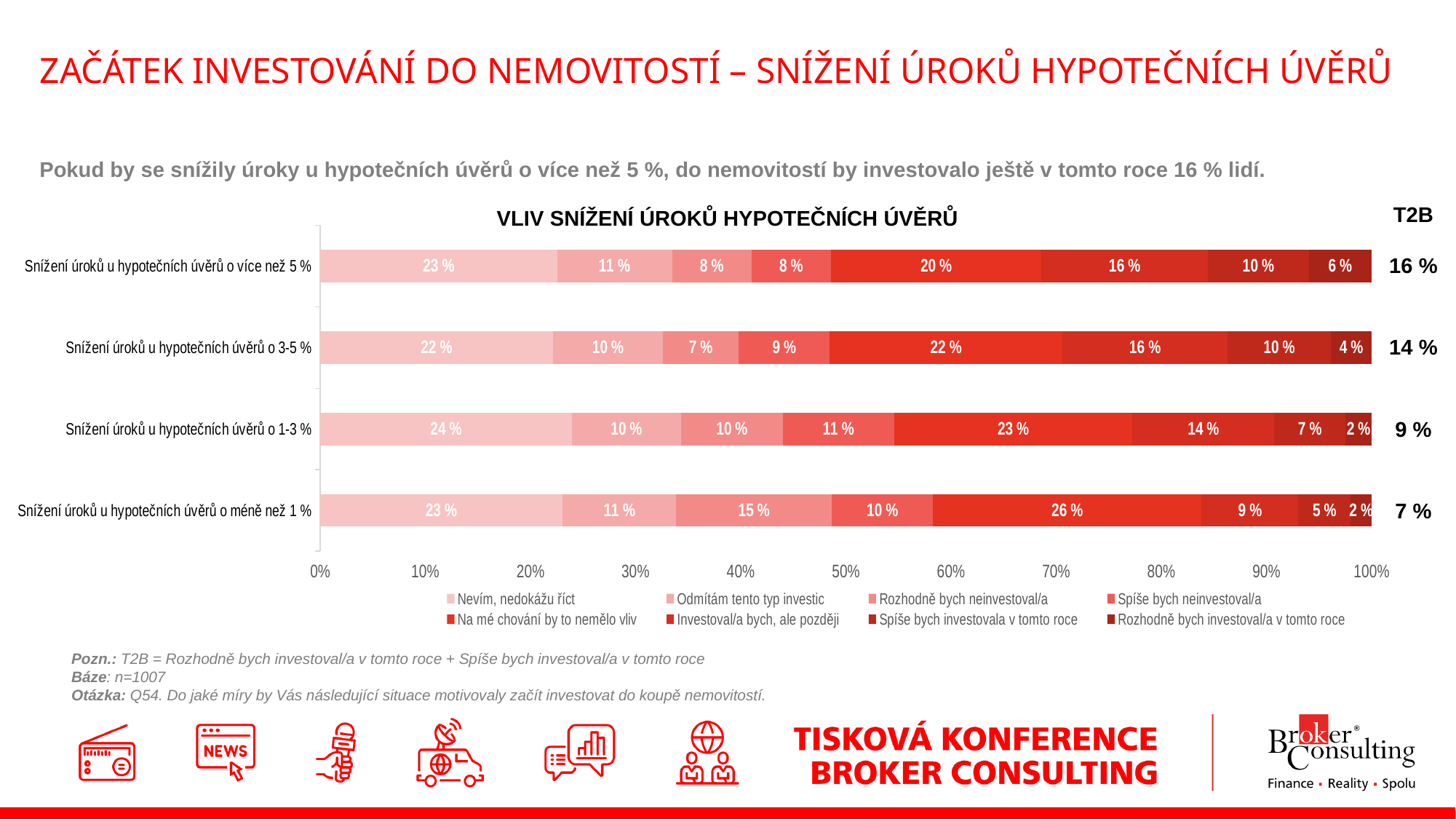
What is the difference between the T2B values for "o více než 5 %" and "o méně než 1 %"? 9 % Which category has the lowest T2B value? Snížení úroků u hypotečních úvěrů o méně než 1 % Which has the larger "Nevím, nedokážu říct" value: "o 1-3 %" or "o 3-5 %"? Snížení úroků u hypotečních úvěrů o 1-3 % What is the value of "Investoval/a bych, ale později" for "Snížení úroků u hypotečních úvěrů o 1-3 %"? 14 % Which category has the highest T2B value? Snížení úroků u hypotečních úvěrů o více než 5 % What is the difference between the "Na mé chování by to nemělo vliv" values for "o méně než 1 %" and "o více než 5 %"? 6 % What is the T2B value shown for "Snížení úroků u hypotečních úvěrů o 3-5 %"? 14 % How many series does the legend list? 8 How many categories (bars) does the chart show? 4 What is the value of "Rozhodně bych investoval/a v tomto roce" for "Snížení úroků u hypotečních úvěrů o více než 5 %"? 6 % What is the value of "Na mé chování by to nemělo vliv" for "Snížení úroků u hypotečních úvěrů o méně než 1 %"? 26 % What type of chart is shown on the slide? Stacked bar chart